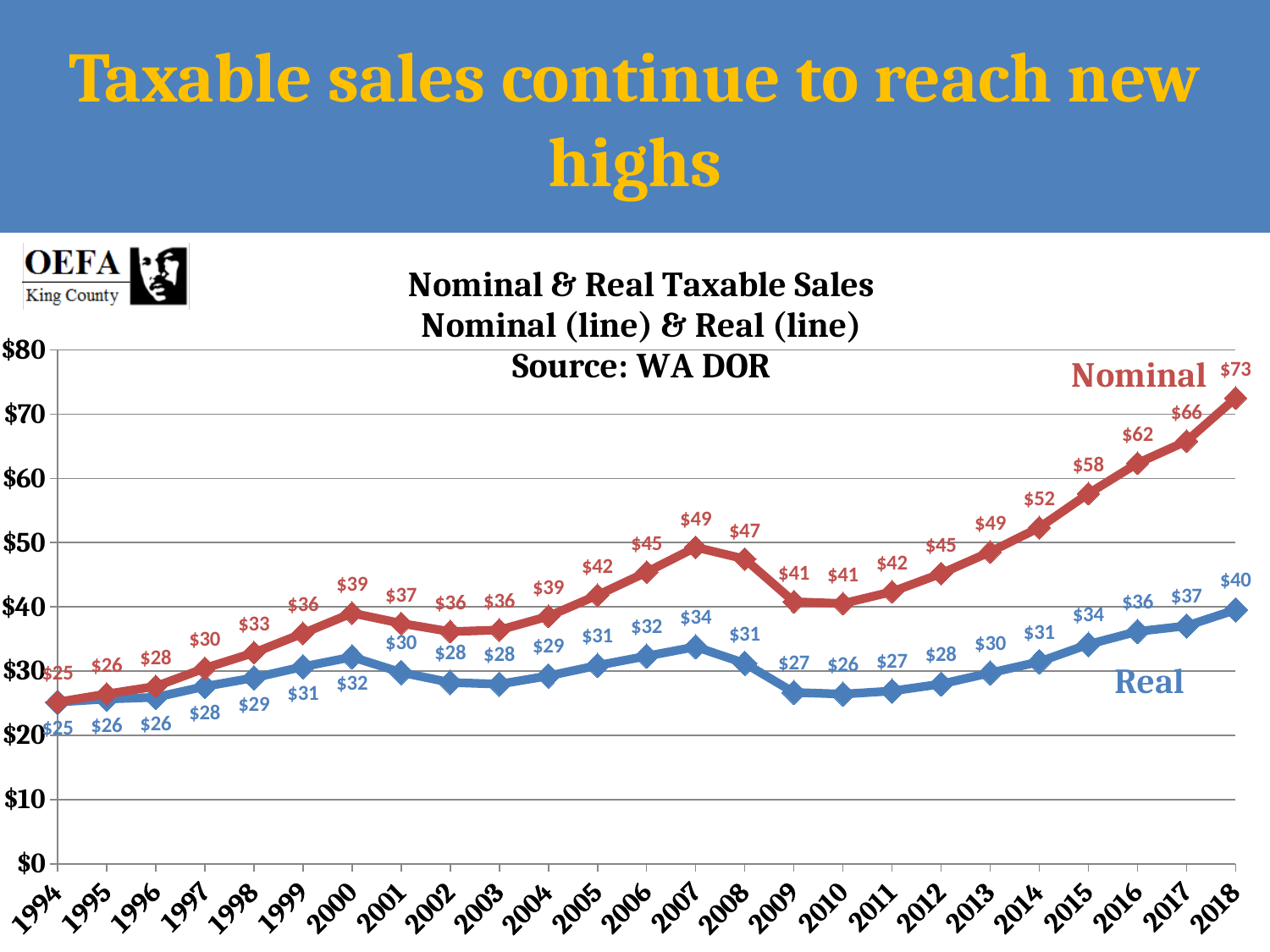
What type of chart is shown on the slide? Line chart What is the Nominal taxable sales value for 2018? $73 What is the source cited in the chart title? WA DOR What is the Nominal taxable sales value for 2009? $41 What is the Real taxable sales value for 2018? $40 What is the Real taxable sales value for 2007? $34 Which is larger, the Real value for 2000 or the Real value for 2010? 2000 In which year is the Nominal series at its lowest value? 1994 How many years are plotted on the x axis? 25 What is the difference between the Nominal and Real values in 2018? $33 In which year does the Nominal series reach its highest value? 2018 What is the difference between the Nominal values for 2007 and 2009? $8